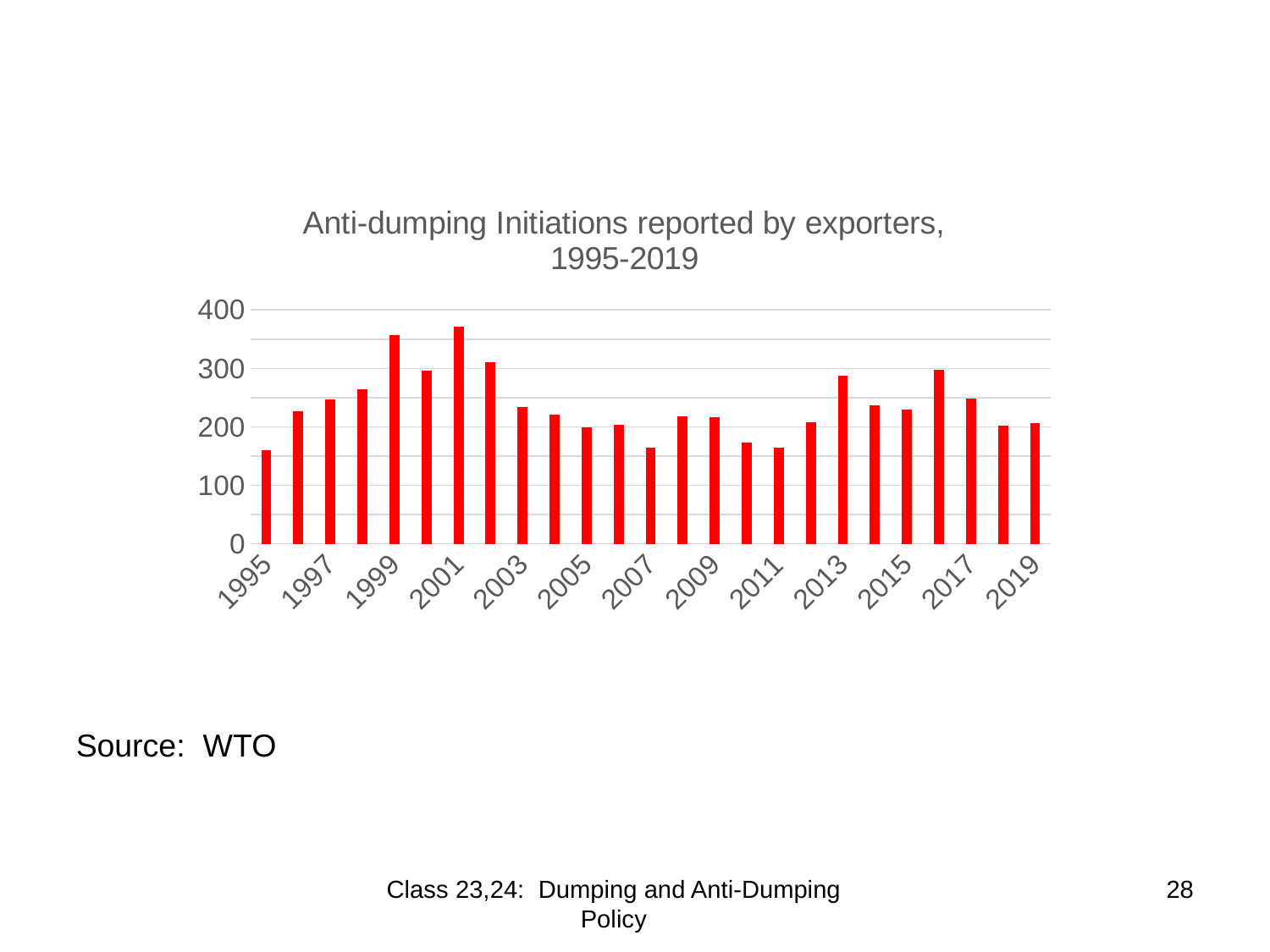
Which year has the larger value, 2012 or 2013? 2013 Do the values generally rise or fall from 1995 to 2001? rise Which year has the larger value, 2001 or 2007? 2001 Which year has the highest number of anti-dumping initiations? 2001 Is the value for 1995 greater or less than 200? less Is the value for 2007 greater or less than 200? less Is the value for 1999 greater or less than 300? greater How many years (bars) are plotted in the chart? 25 What kind of chart is shown on the slide? bar chart What is the title of the chart? Anti-dumping Initiations reported by exporters, 1995-2019